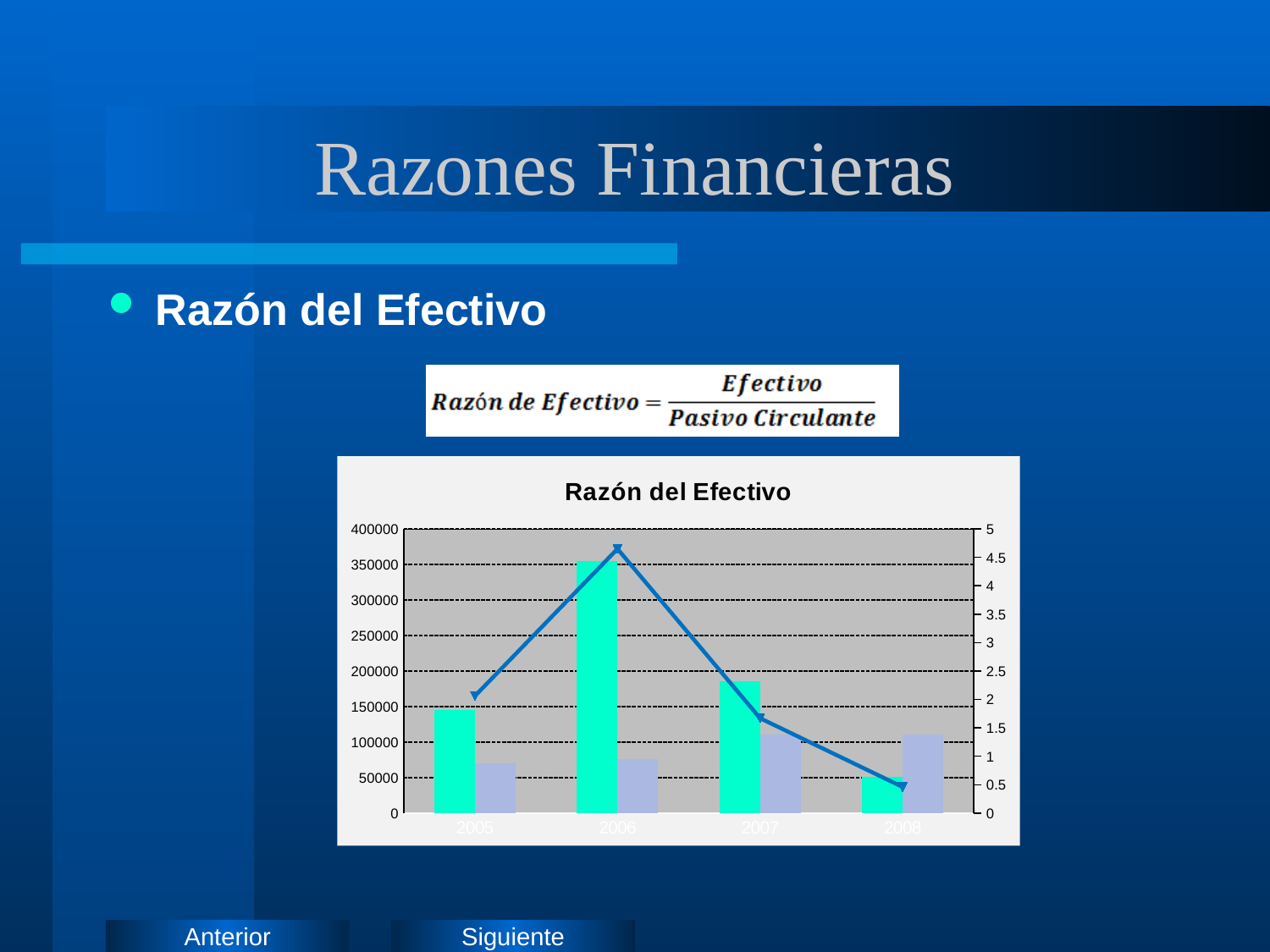
In which year does the line reach its lowest point? 2008 Is the value of the cyan bar for 2008 greater or less than 100000? less Does the line rise or fall from 2006 to 2008? It falls What kind of chart is shown on the slide? A combination bar and line chart Is the value of the cyan bar for 2006 greater or less than 300000? greater In which year does the line reach its highest point? 2006 Which year has the larger cyan bar, 2005 or 2007? 2007 What is the title of the chart on the slide? Razón del Efectivo On the right axis, is the line value for 2006 greater or less than 4? greater In which year is the cyan bar the tallest? 2006 How many years are shown on the x axis of the chart? 4 In which year is the cyan bar the shortest? 2008